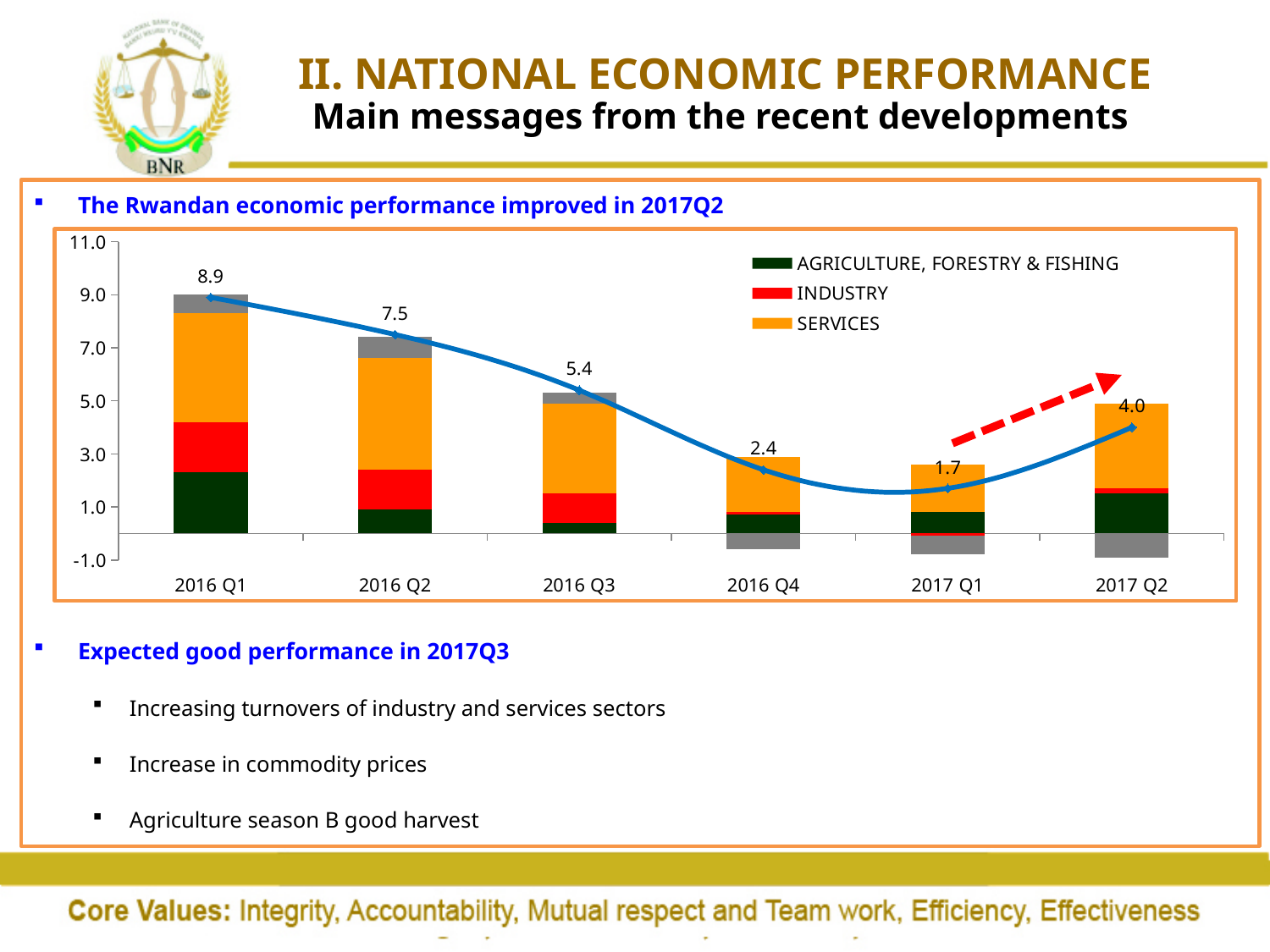
Which quarter has the highest labelled value? 2016 Q1 How many series does the legend list? 3 What kind of chart is shown? Stacked bar chart with a line Do the labelled values rise or fall from 2016 Q1 to 2017 Q1? Fall Which quarter has the lowest labelled value? 2017 Q1 How many quarters are shown on the x axis? 6 What is the difference between the labelled values for 2016 Q1 and 2016 Q2? 1.4 What is the difference between the labelled values for 2017 Q2 and 2017 Q1? 2.3 What value is labelled for 2016 Q1? 8.9 What value is labelled for 2017 Q2? 4.0 What value is labelled for 2016 Q4? 2.4 Which has the larger labelled value, 2016 Q3 or 2017 Q2? 2016 Q3